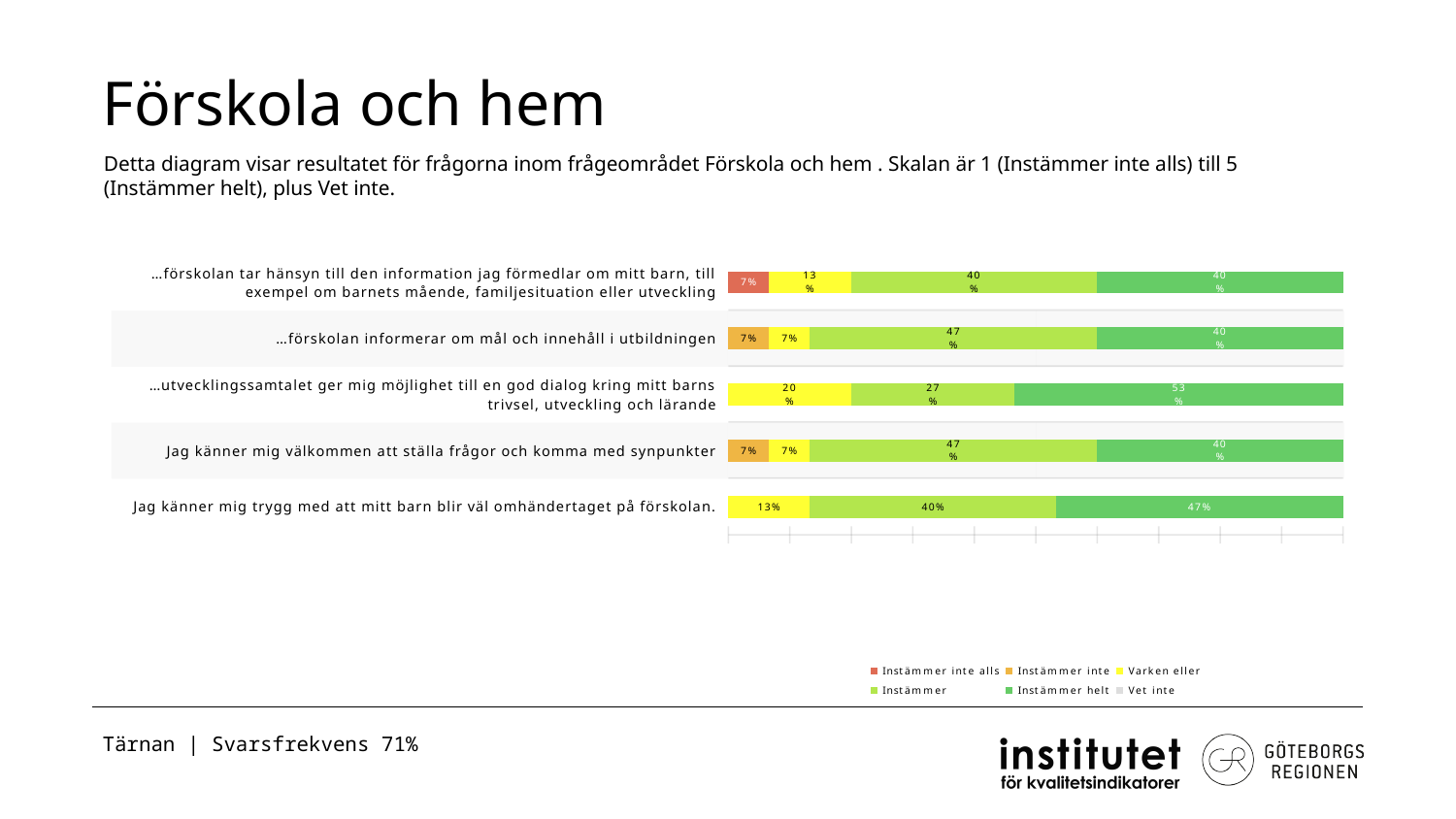
For '…utvecklingssamtalet ger mig möjlighet till en god dialog kring mitt barns trivsel, utveckling och lärande', how much larger is the 'Instämmer helt' share than the 'Instämmer' share? 26 percentage points What is the 'Instämmer' value for 'Jag känner mig trygg med att mitt barn blir väl omhändertaget på förskolan.'? 40% What is the 'Varken eller' value for '…utvecklingssamtalet ger mig möjlighet till en god dialog kring mitt barns trivsel, utveckling och lärande'? 20% What is the 'Varken eller' value for 'Jag känner mig trygg med att mitt barn blir väl omhändertaget på förskolan.'? 13% How many statements (categories) are plotted in the chart? 5 What is the 'Instämmer helt' value for '…förskolan informerar om mål och innehåll i utbildningen'? 40% How many series does the legend list? 6 What kind of chart is shown on the slide? Stacked bar chart Which statement has the highest 'Instämmer helt' share? …utvecklingssamtalet ger mig möjlighet till en god dialog kring mitt barns trivsel, utveckling och lärande Which has the larger 'Instämmer helt' share: 'Jag känner mig trygg med att mitt barn blir väl omhändertaget på förskolan.' or 'Jag känner mig välkommen att ställa frågor och komma med synpunkter'? Jag känner mig trygg med att mitt barn blir väl omhändertaget på förskolan. Which statement has the lowest 'Instämmer' share? …utvecklingssamtalet ger mig möjlighet till en god dialog kring mitt barns trivsel, utveckling och lärande What is the 'Instämmer helt' value for '…utvecklingssamtalet ger mig möjlighet till en god dialog kring mitt barns trivsel, utveckling och lärande'? 53%